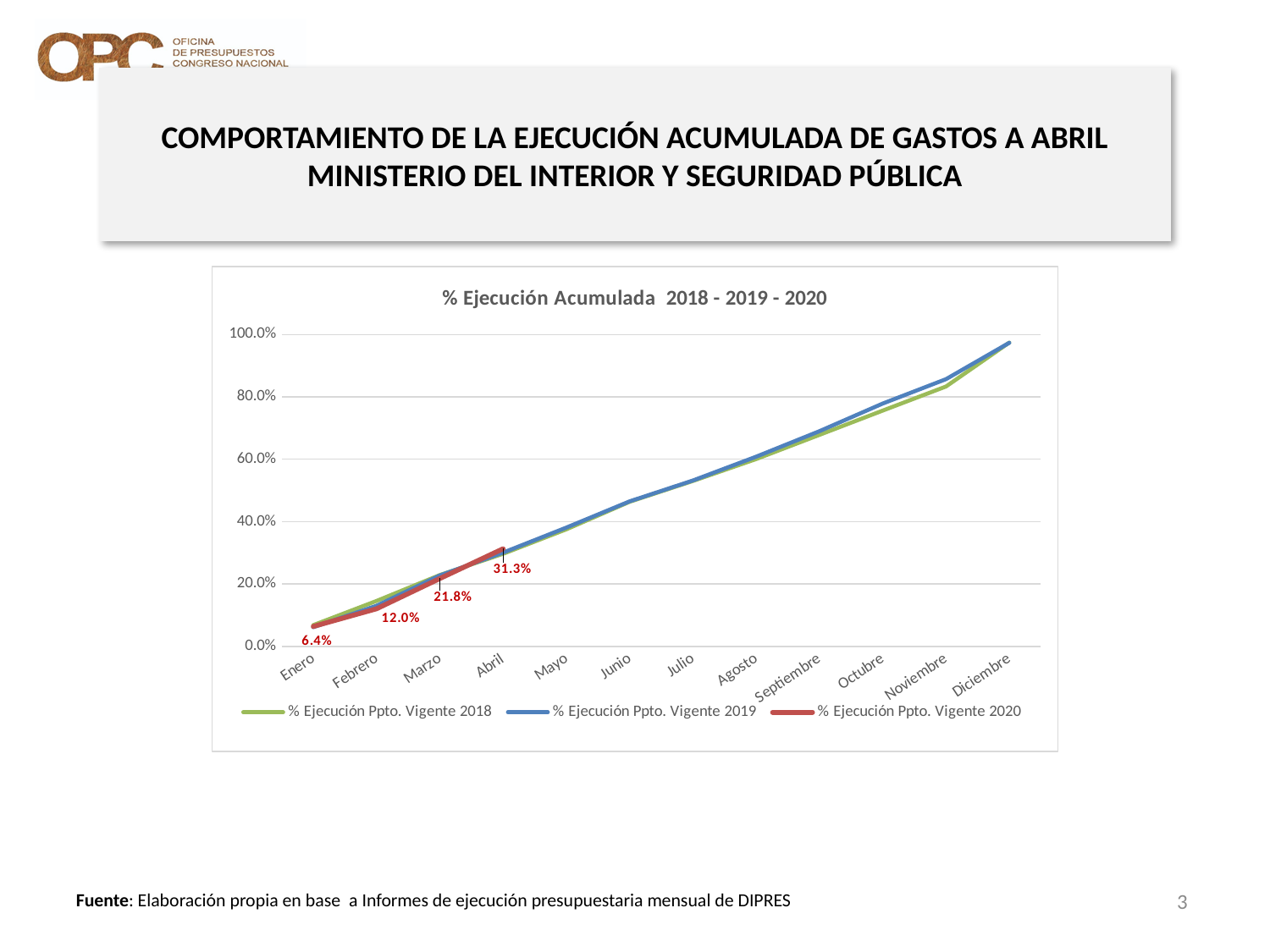
What is the value for % Ejecución Ppto. Vigente 2020 in Febrero? 12.0% By how many percentage points did % Ejecución Ppto. Vigente 2020 increase from Marzo to Abril? 9.5 What is the title of the chart? % Ejecución Acumulada 2018 - 2019 - 2020 Is the value for % Ejecución Ppto. Vigente 2019 in Diciembre greater or less than 80.0%? greater Which month has the highest value for % Ejecución Ppto. Vigente 2020? Abril What is the value for % Ejecución Ppto. Vigente 2020 in Abril? 31.3% How many series does the legend list? 3 What is the value for % Ejecución Ppto. Vigente 2020 in Enero? 6.4% Do the values for % Ejecución Ppto. Vigente 2019 rise or fall from Enero to Diciembre? rise What is the value for % Ejecución Ppto. Vigente 2020 in Marzo? 21.8% How many months are shown along the x axis? 12 What kind of chart is shown on the slide? line chart